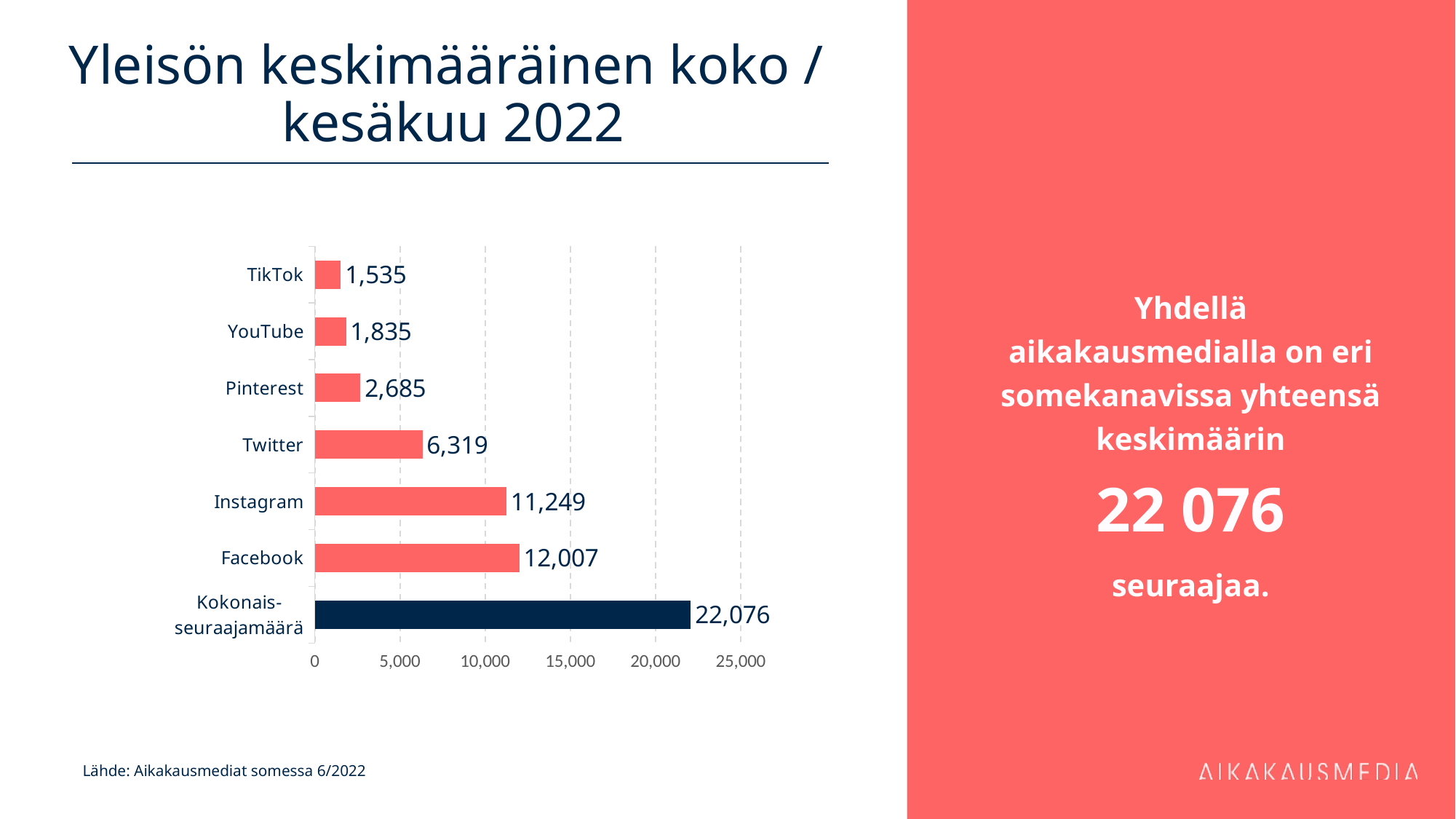
What kind of chart is shown on the slide? Bar chart Which category has the lowest value? TikTok What is the value for TikTok? 1,535 What is the difference between the values for Facebook and Instagram? 758 What is the value for Kokonais-seuraajamäärä? 22,076 How many categories are shown in the chart? 7 Which is larger, the value for Pinterest or the value for Twitter? Twitter Which individual social media channel has the highest value? Facebook What is the title of the slide? Yleisön keskimääräinen koko / kesäkuu 2022 What is the value for Facebook? 12,007 What is the difference between the values for YouTube and TikTok? 300 What is the value for Twitter? 6,319